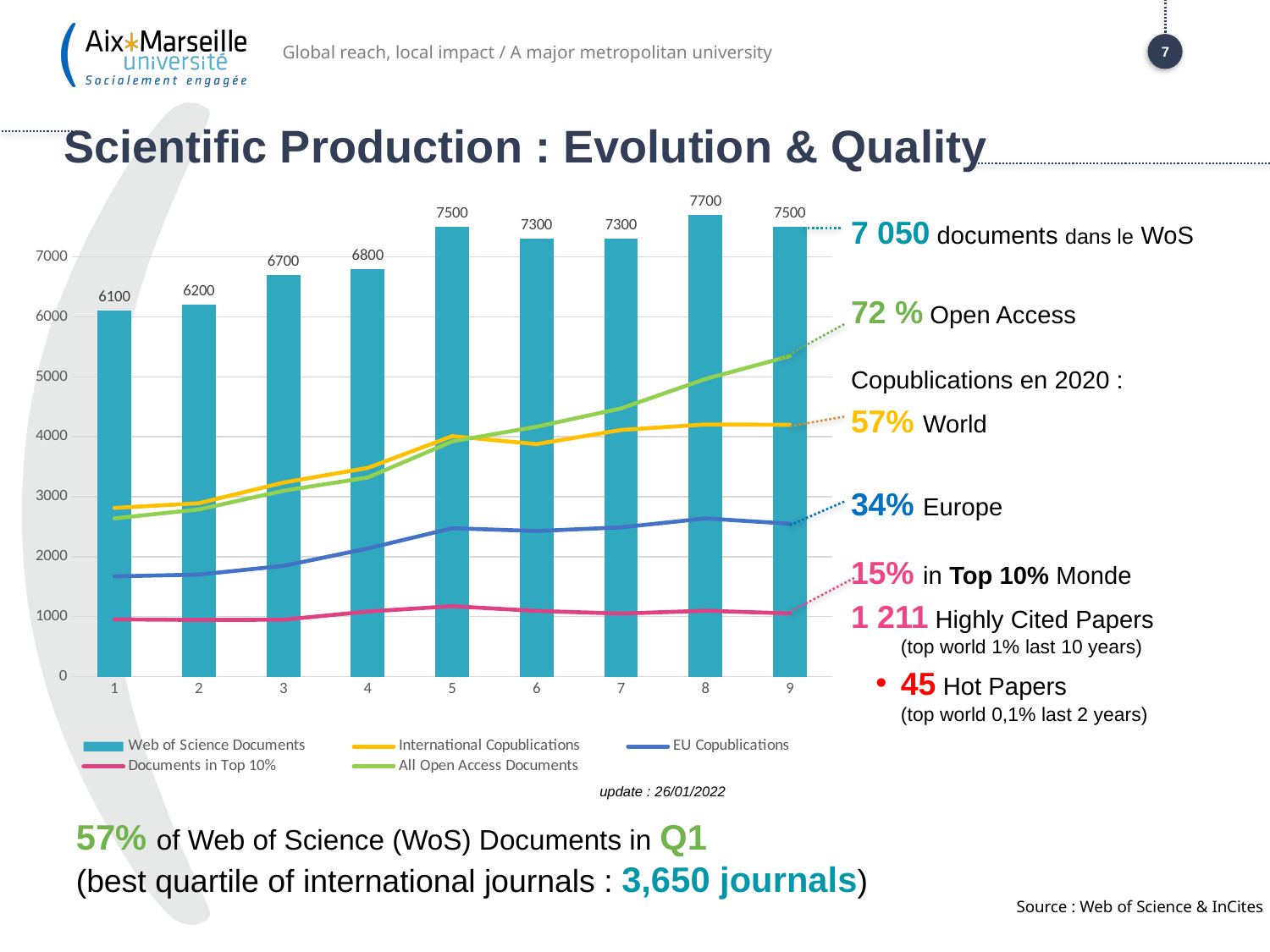
Is the value of All Open Access Documents for category 9 greater or less than 5000? greater Do the Web of Science Documents values generally rise or fall from category 1 to category 9? rise Which category has the lowest value for Web of Science Documents? 1 Is the value of EU Copublications for category 1 greater or less than 2000? less What is the value of Web of Science Documents for category 8? 7700 Which category has the highest value for Web of Science Documents? 8 How many categories are shown on the x axis? 9 What is the value of Web of Science Documents for category 1? 6100 Which series is drawn as bars in the chart? Web of Science Documents What is the difference between the Web of Science Documents values for category 9 and category 1? 1400 Which is larger, the Web of Science Documents value for category 5 or for category 6? category 5 How many series does the legend list? 5